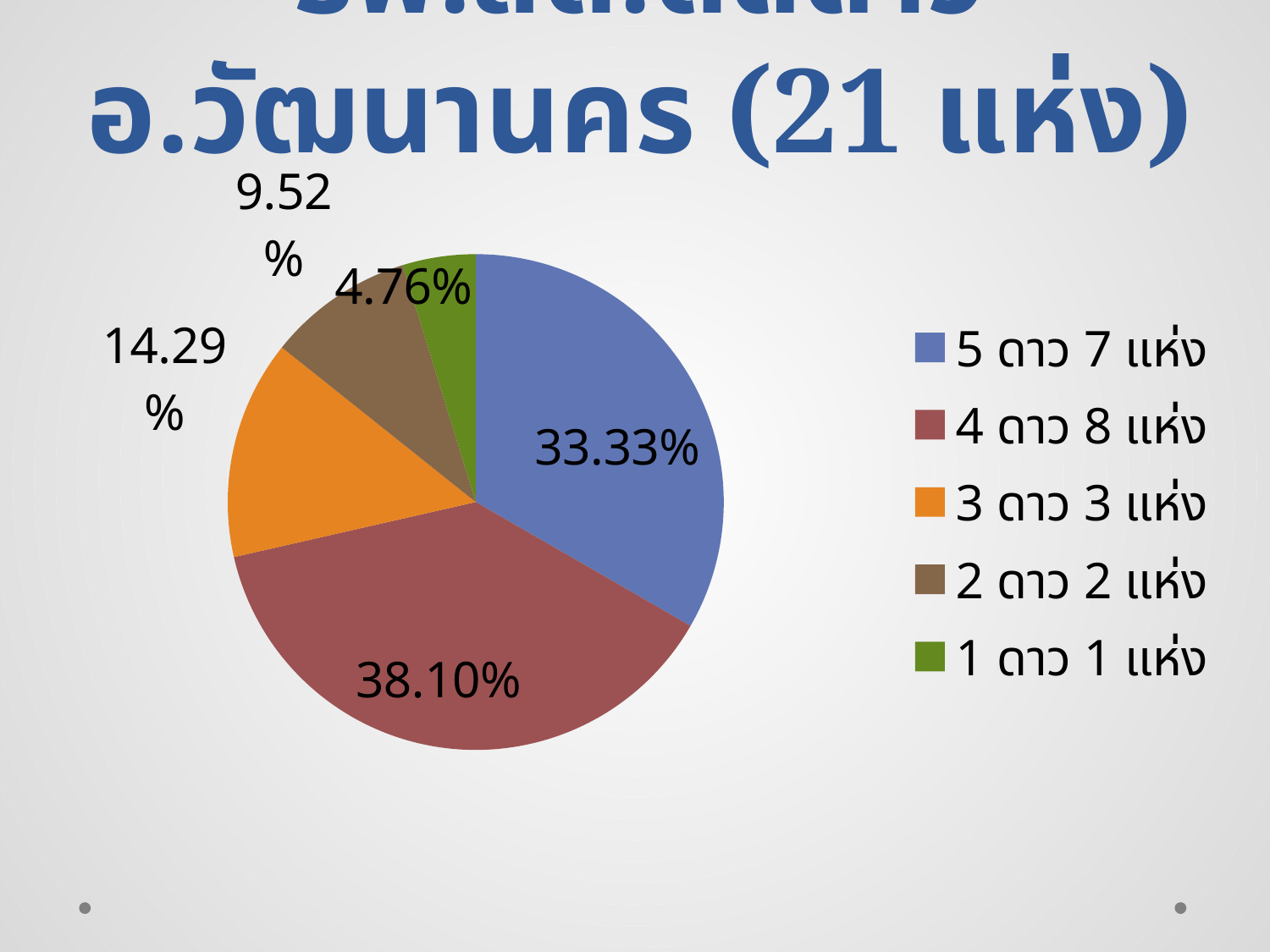
What percentage share does the 2 ดาว 2 แห่ง slice have? 9.52% Which slice is larger, 5 ดาว 7 แห่ง or 3 ดาว 3 แห่ง? 5 ดาว 7 แห่ง What percentage share does the 1 ดาว 1 แห่ง slice have? 4.76% What kind of chart is shown on the slide? pie chart How many categories does the legend list? 5 What is the difference in percentage points between the 4 ดาว 8 แห่ง slice and the 5 ดาว 7 แห่ง slice? 4.77% What percentage share does the 3 ดาว 3 แห่ง slice have? 14.29% What percentage share does the 5 ดาว 7 แห่ง slice have? 33.33% Which category has the largest slice of the pie? 4 ดาว 8 แห่ง Which category has the smallest slice of the pie? 1 ดาว 1 แห่ง What colour is the slice for 3 ดาว 3 แห่ง? orange What percentage share does the 4 ดาว 8 แห่ง slice have? 38.10%